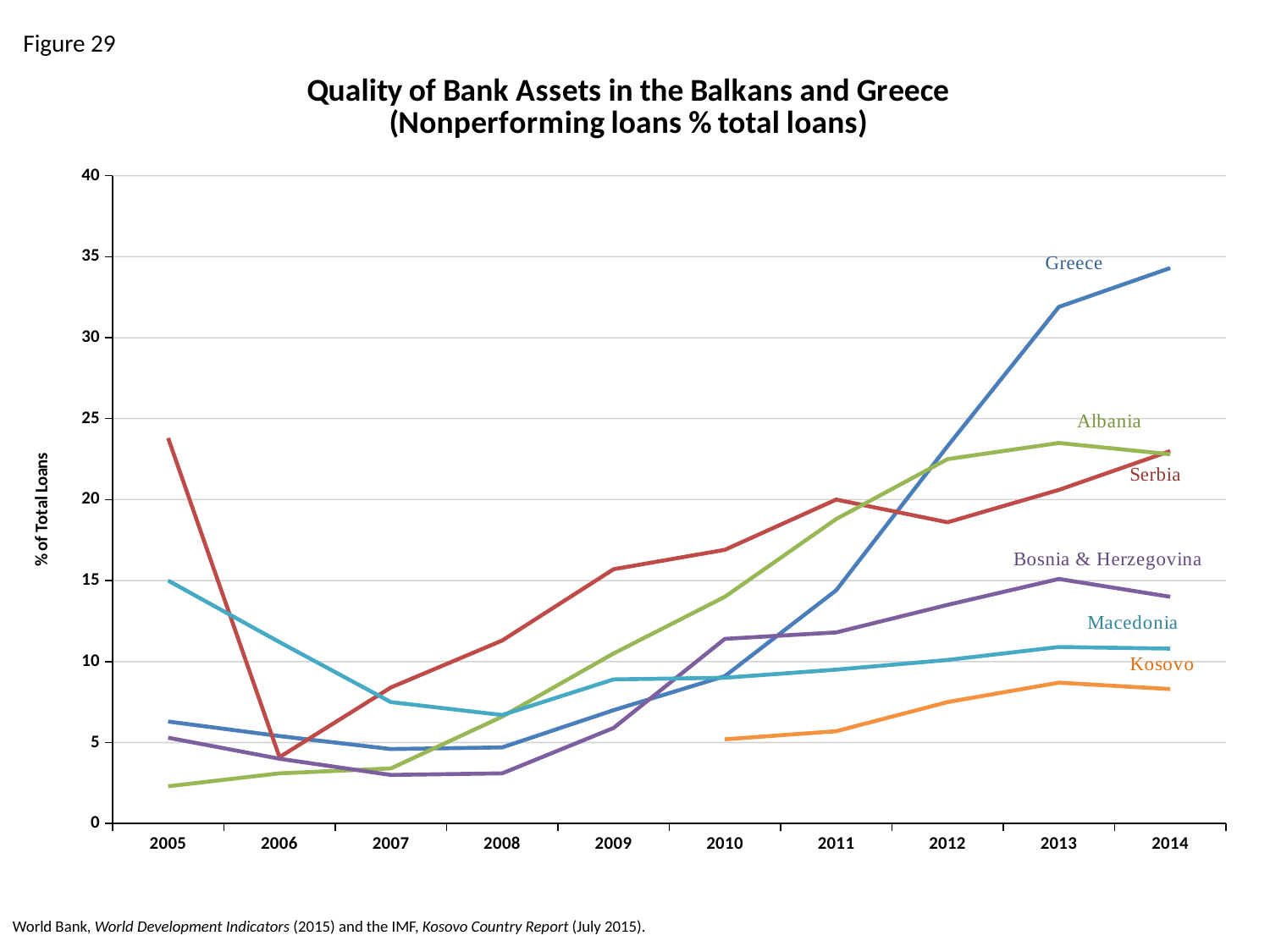
Is the value for Greece in 2014 greater or less than 30? greater How many countries are plotted as lines on the chart? 6 How many years are shown along the x axis? 10 Which country has the highest nonperforming loan ratio in 2014? Greece Which country has the lowest nonperforming loan ratio in 2014? Kosovo Is the value for Kosovo in 2013 greater or less than 10? less Which country's line starts only in 2010? Kosovo In 2014, which is larger, the value for Greece or the value for Serbia? Greece Is the value for Albania in 2005 greater or less than 5? less What kind of chart is shown on the slide? line chart Does the line for Greece rise or fall between 2008 and 2014? rise